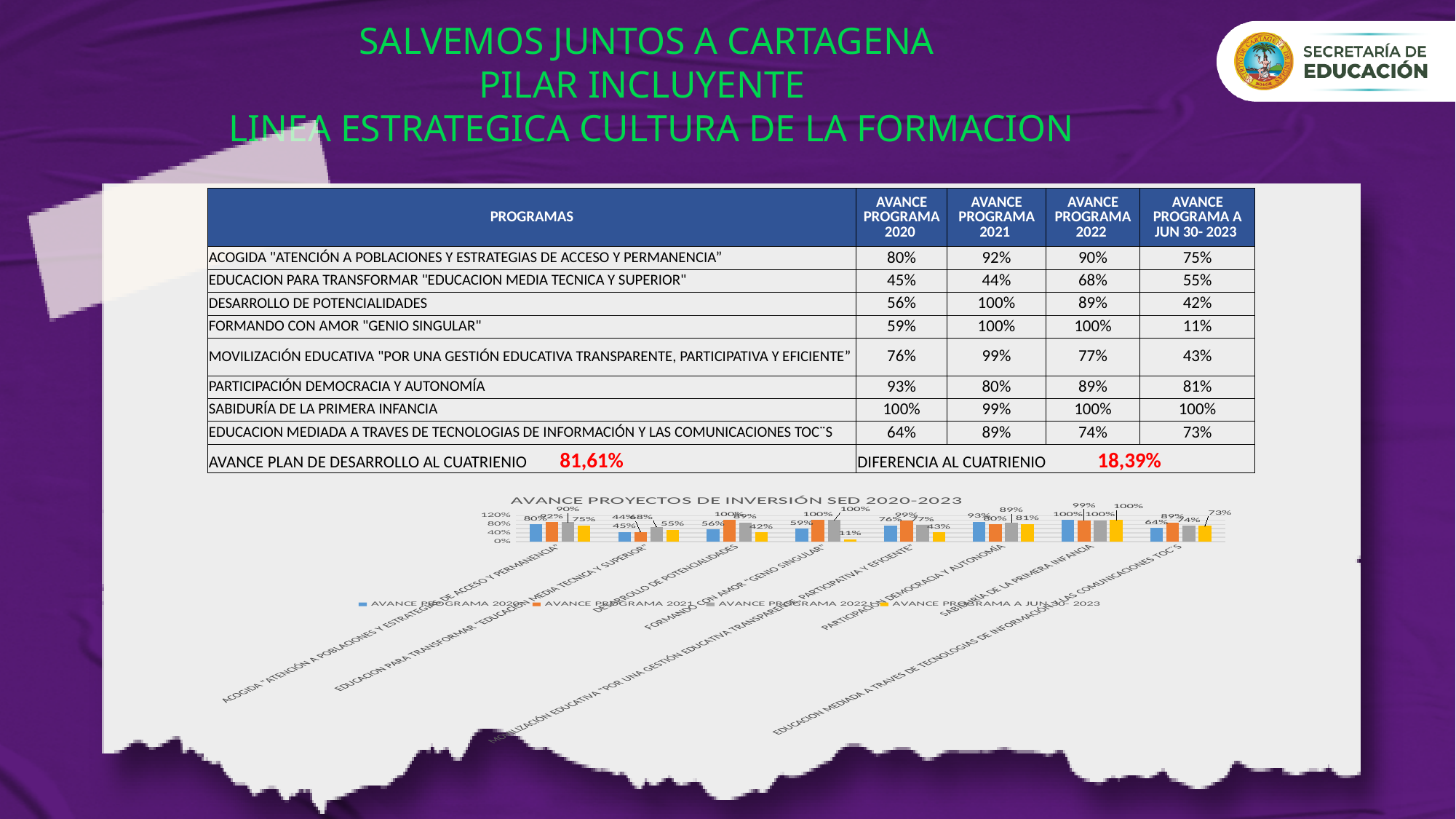
In the chart, what is the AVANCE PROGRAMA A JUN 30- 2023 value for FORMANDO CON AMOR "GENIO SINGULAR"? 11% In the chart, which is larger for PARTICIPACIÓN DEMOCRACIA Y AUTONOMÍA: the AVANCE PROGRAMA 2020 value or the AVANCE PROGRAMA 2021 value? AVANCE PROGRAMA 2020 In the chart, which program has the lowest AVANCE PROGRAMA A JUN 30- 2023 value? FORMANDO CON AMOR "GENIO SINGULAR" In the chart, what is the difference between the AVANCE PROGRAMA 2021 and AVANCE PROGRAMA 2020 values for ACOGIDA "ATENCIÓN A POBLACIONES Y ESTRATEGIAS DE ACCESO Y PERMANENCIA"? 12% What is the title of the chart on the slide? AVANCE PROYECTOS DE INVERSIÓN SED 2020-2023 How many series does the chart legend list? 4 In the chart, which program has the lowest AVANCE PROGRAMA 2020 value? EDUCACION PARA TRANSFORMAR "EDUCACION MEDIA TECNICA Y SUPERIOR" In the chart, what is the AVANCE PROGRAMA 2020 value for SABIDURÍA DE LA PRIMERA INFANCIA? 100% What kind of chart is shown below the table? bar chart How many program categories are plotted along the x axis of the chart? 8 Which colour represents the AVANCE PROGRAMA A JUN 30- 2023 series in the chart? yellow In the chart, what is the AVANCE PROGRAMA 2021 value for DESARROLLO DE POTENCIALIDADES? 100%